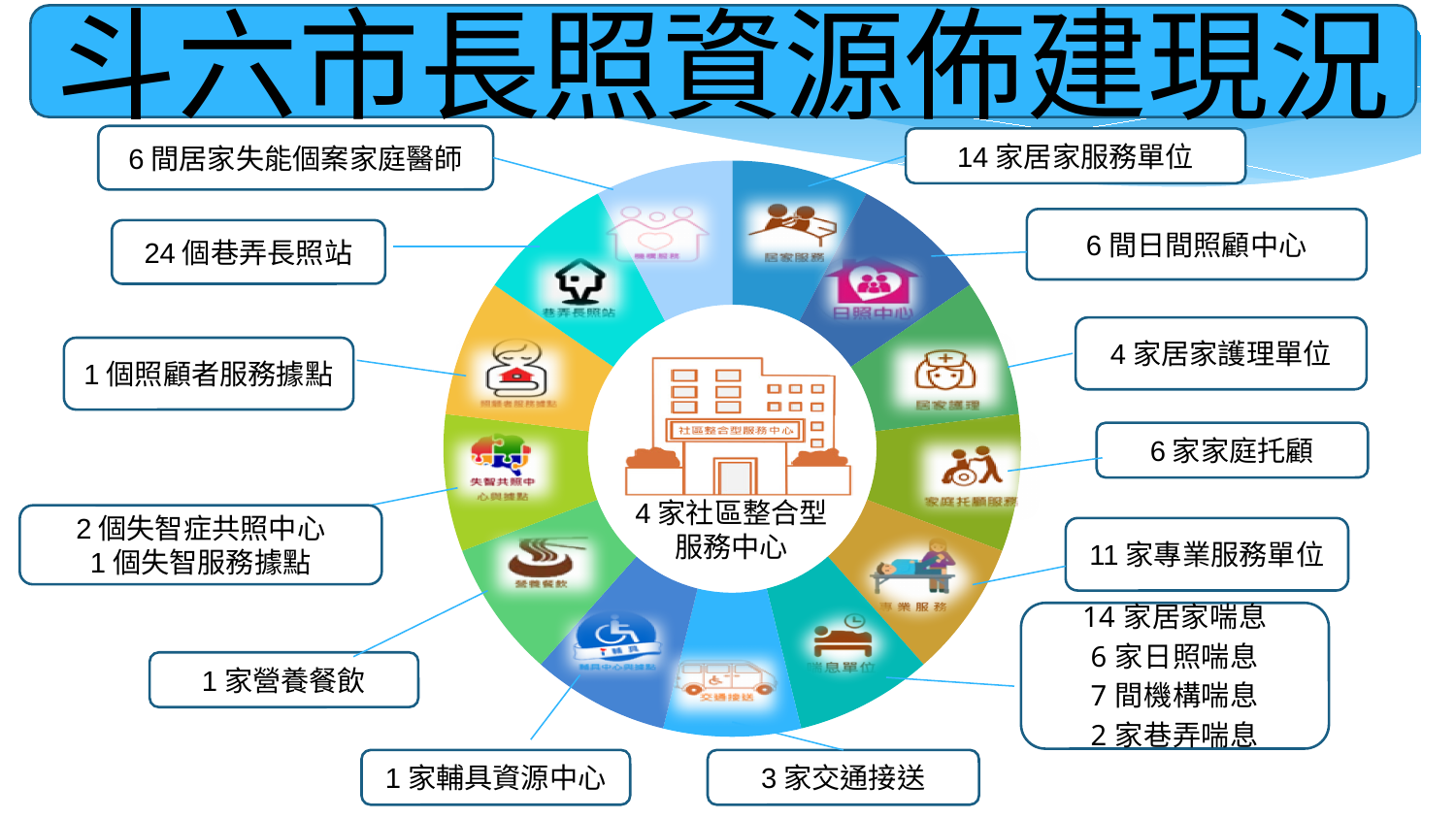
What is the difference between the number of 居家服務單位 (14) and 日間照顧中心 (6)? 8 How many 失智症共照中心 are listed on the slide? 2 個 What is the layout of the diagram on the slide? A ring of icons around a central 社區整合型服務中心 icon with callout labels How many 日間照顧中心 are shown on the slide? 6 間 How many 專業服務單位 does the slide list? 11 家 How many 交通接送 providers are shown on the slide? 3 家 How many 社區整合型服務中心 are shown at the centre of the diagram? 4 家 Which has more units on the slide: 居家服務單位 or 居家護理單位? 居家服務單位 How many 巷弄長照站 are listed on the slide? 24 個 What is the title of the slide? 斗六市長照資源佈建現況 How many 機構喘息 units are listed in the 喘息 callout? 7 間 How many 居家服務單位 does the slide report for 斗六市? 14 家